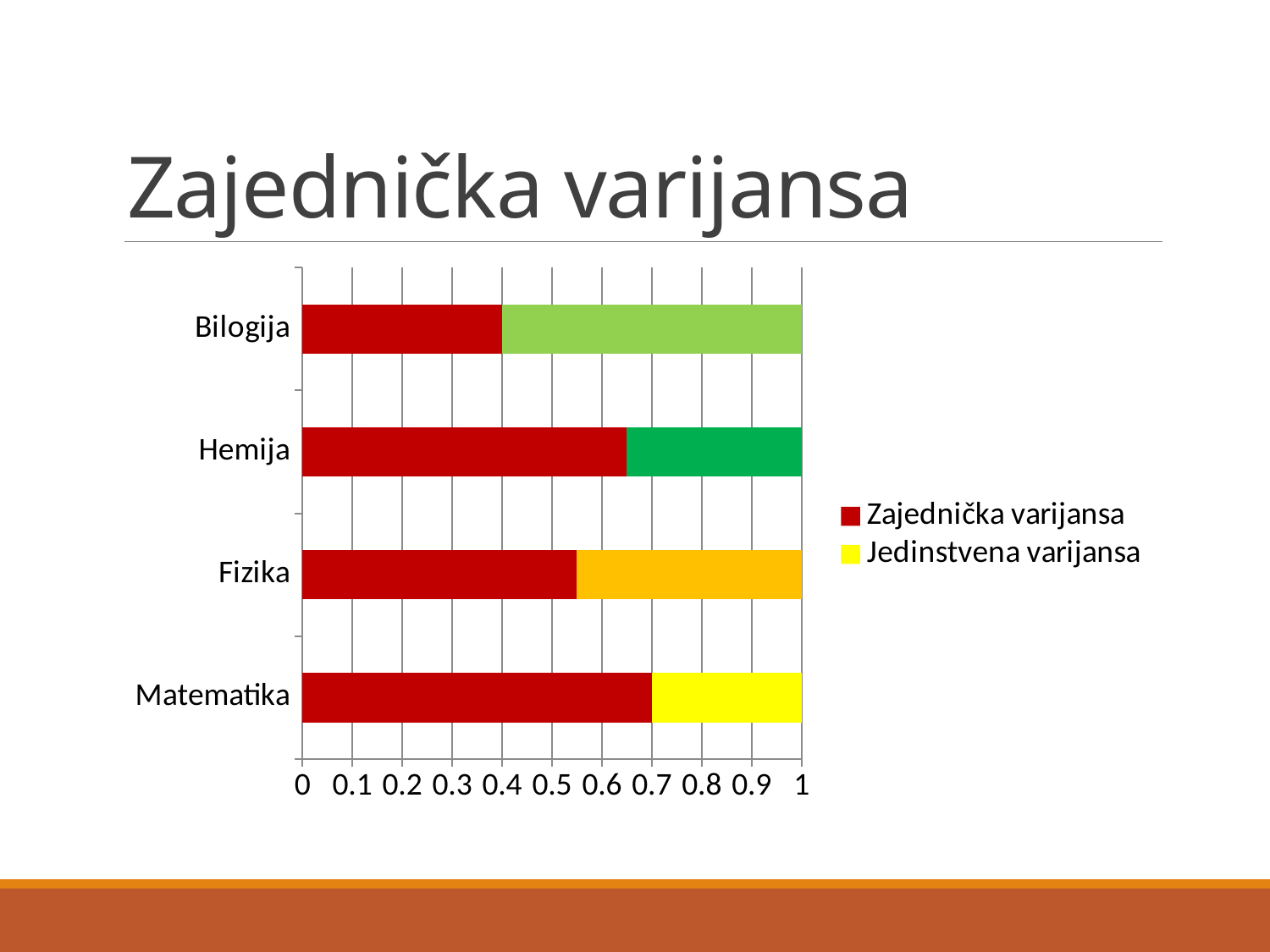
What is the Zajednička varijansa value for Bilogija? 0.4 What is the Zajednička varijansa value for Matematika? 0.7 Is the Zajednička varijansa value for Fizika greater or less than 0.6? less How many categories are shown on the chart? 4 What kind of chart is shown on the slide? bar chart Which has a larger Zajednička varijansa, Bilogija or Hemija? Hemija What is the difference between the Zajednička varijansa values for Matematika and Bilogija? 0.3 What is the total of the stacked bar for Matematika? 1 Which category has the highest Zajednička varijansa? Matematika How many series does the legend list? 2 Which category has the lowest Zajednička varijansa? Bilogija Is the Zajednička varijansa value for Hemija greater or less than 0.6? greater